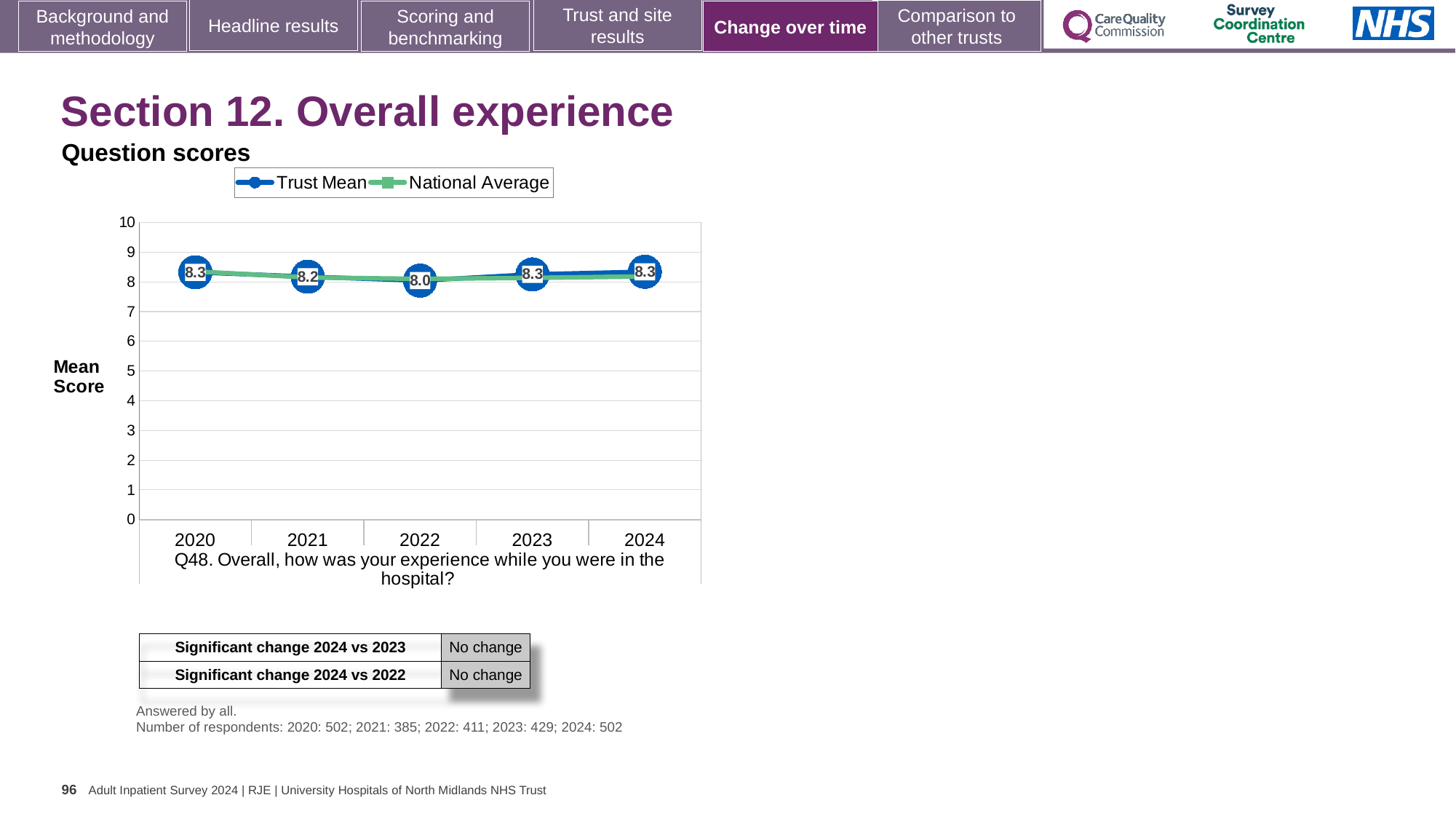
What is the Trust Mean score for 2022? 8.0 What are the two series named in the legend? Trust Mean and National Average What kind of chart is shown on the slide? line chart How many series does the legend list? 2 Is the Trust Mean score for 2023 greater or less than 7? greater What is the difference between the Trust Mean scores for 2020 and 2022? 0.3 Does the Trust Mean score rise or fall from 2022 to 2024? rise Which year has the larger Trust Mean score, 2021 or 2022? 2021 What is the Trust Mean score for 2021? 8.2 What is the Trust Mean score for 2020? 8.3 How many years are plotted on the x axis? 5 In which year is the Trust Mean score lowest? 2022